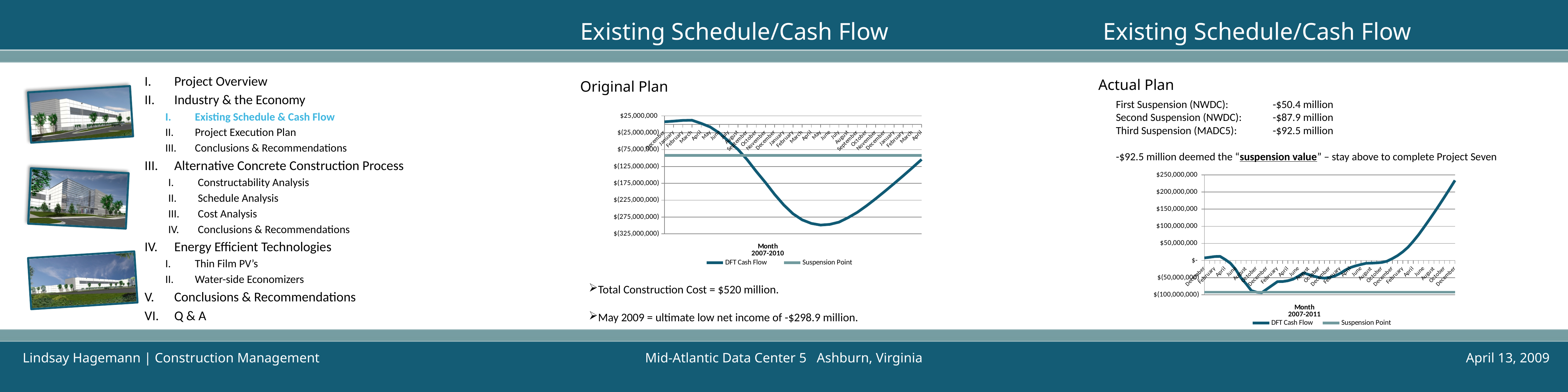
In the Original Plan chart, is the lowest point of the DFT Cash Flow line greater or less than $(275,000,000)? less In the Original Plan chart, is the Suspension Point line greater or less than $(25,000,000)? less What is the x-axis title of the Original Plan chart? Month 2007-2010 What are the two series named in the legend of the Actual Plan chart? DFT Cash Flow and Suspension Point What kind of chart is the Actual Plan chart? Line chart What kind of chart is the Original Plan chart? Line chart In the Actual Plan chart, is the Suspension Point line greater or less than $(50,000,000)? less In the Actual Plan chart, does the DFT Cash Flow line rise or fall over the last third of the x axis? rise In the Original Plan chart, does the DFT Cash Flow line rise or fall over the first half of the x axis? fall How many series does the legend of the Original Plan chart list? 2 How many series does the legend of the Actual Plan chart list? 2